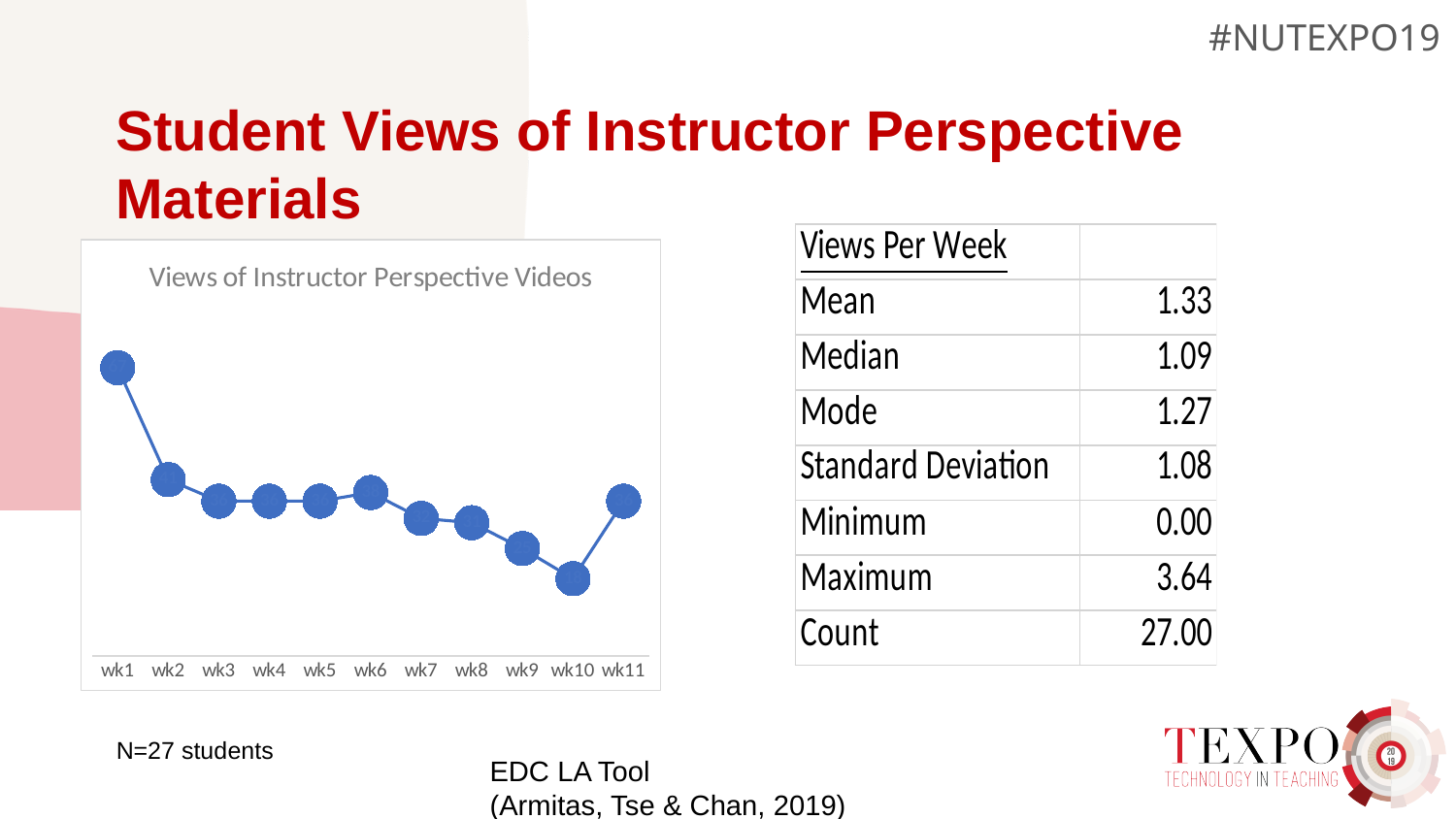
Which has more views, wk9 or wk11? wk11 Which has more views, wk10 or wk11? wk11 What is the first category label on the x axis of the chart? wk1 Which week has the highest number of views in the chart? wk1 Which has more views, wk6 or wk7? wk6 What is the title of the chart? Views of Instructor Perspective Videos Do the views generally rise or fall from wk1 to wk10? fall How many weeks are plotted on the x axis of the chart? 11 What kind of chart is shown on the slide? line chart Which week has the lowest number of views in the chart? wk10